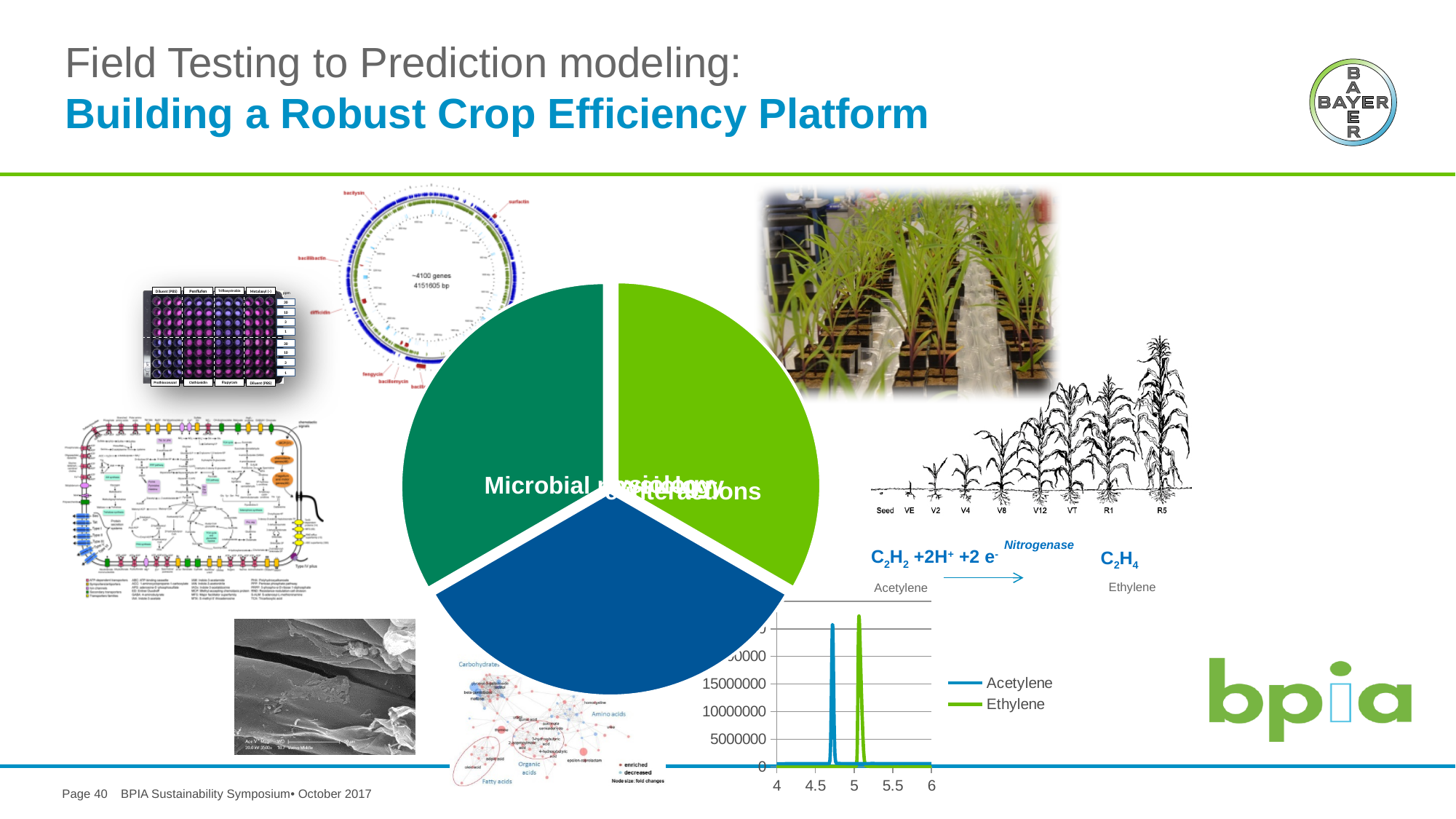
What are the two series named in the legend of the line chart at the bottom right? Acetylene and Ethylene What kind of chart is the chart in the centre of the slide? pie chart In the line chart at the bottom right, is the Ethylene value at x = 6 greater or less than 5000000? less What is the lowest value shown on the x axis of the line chart at the bottom right? 4 How many slices does the pie chart in the centre of the slide have? 3 In the line chart at the bottom right, what colour is the Ethylene line? green In the line chart at the bottom right, which series reaches its peak first along the x axis, Acetylene or Ethylene? Acetylene What kind of chart is the chart at the bottom right showing Acetylene and Ethylene? line chart In the line chart at the bottom right, is the peak value of the Acetylene series greater or less than 15000000? greater In the line chart at the bottom right, is the Acetylene value at x = 4 greater or less than 5000000? less How many series does the legend of the Acetylene/Ethylene line chart list? 2